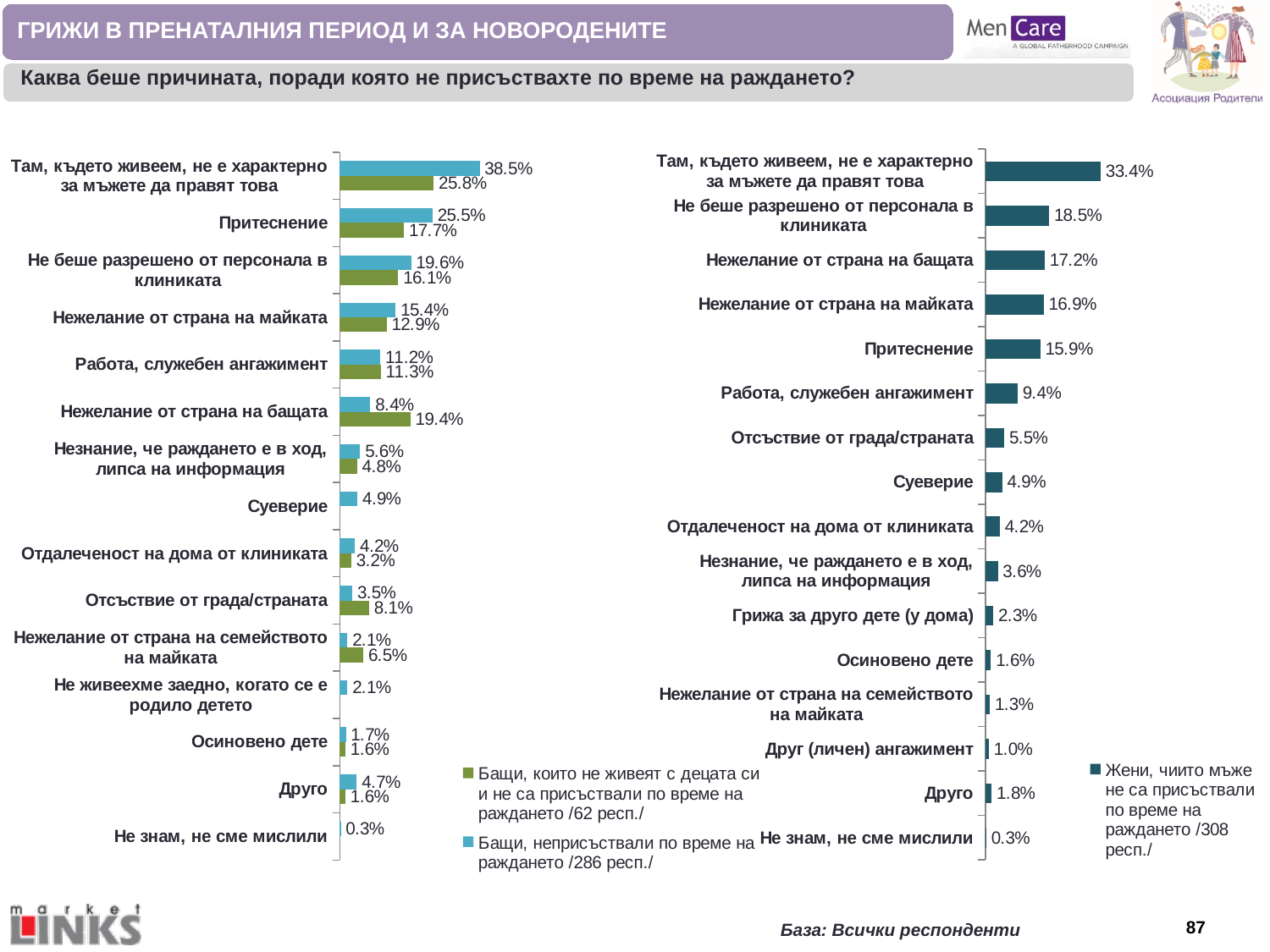
What kind of chart is the right chart? Bar chart In the right chart, which is larger: the value for "Нежелание от страна на бащата" or the value for "Притеснение"? Нежелание от страна на бащата In the right chart, which category has the highest value? Там, където живеем, не е характерно за мъжете да правят това How many series does the legend of the left chart list? 2 In the right chart, what is the value for "Не беше разрешено от персонала в клиниката"? 18.5% In the left chart, for "Отсъствие от града/страната", which series has the larger value: "Бащи, неприсъствали по време на раждането /286 респ./" or "Бащи, които не живеят с децата си и не са присъствали по време на раждането /62 респ./"? Бащи, които не живеят с децата си и не са присъствали по време на раждането /62 респ./ In the right chart, which category has the lowest value? Не знам, не сме мислили In the left chart, what is the value for "Нежелание от страна на бащата" in the series "Бащи, които не живеят с децата си и не са присъствали по време на раждането /62 респ./"? 19.4% In the right chart, what is the difference between the values for "Работа, служебен ангажимент" and "Отсъствие от града/страната"? 3.9% In the left chart, what is the difference between the two series' values for "Там, където живеем, не е характерно за мъжете да правят това"? 12.7% How many categories are shown in the right chart? 16 In the left chart, what is the value for "Притеснение" in the series "Бащи, неприсъствали по време на раждането /286 респ./"? 25.5%